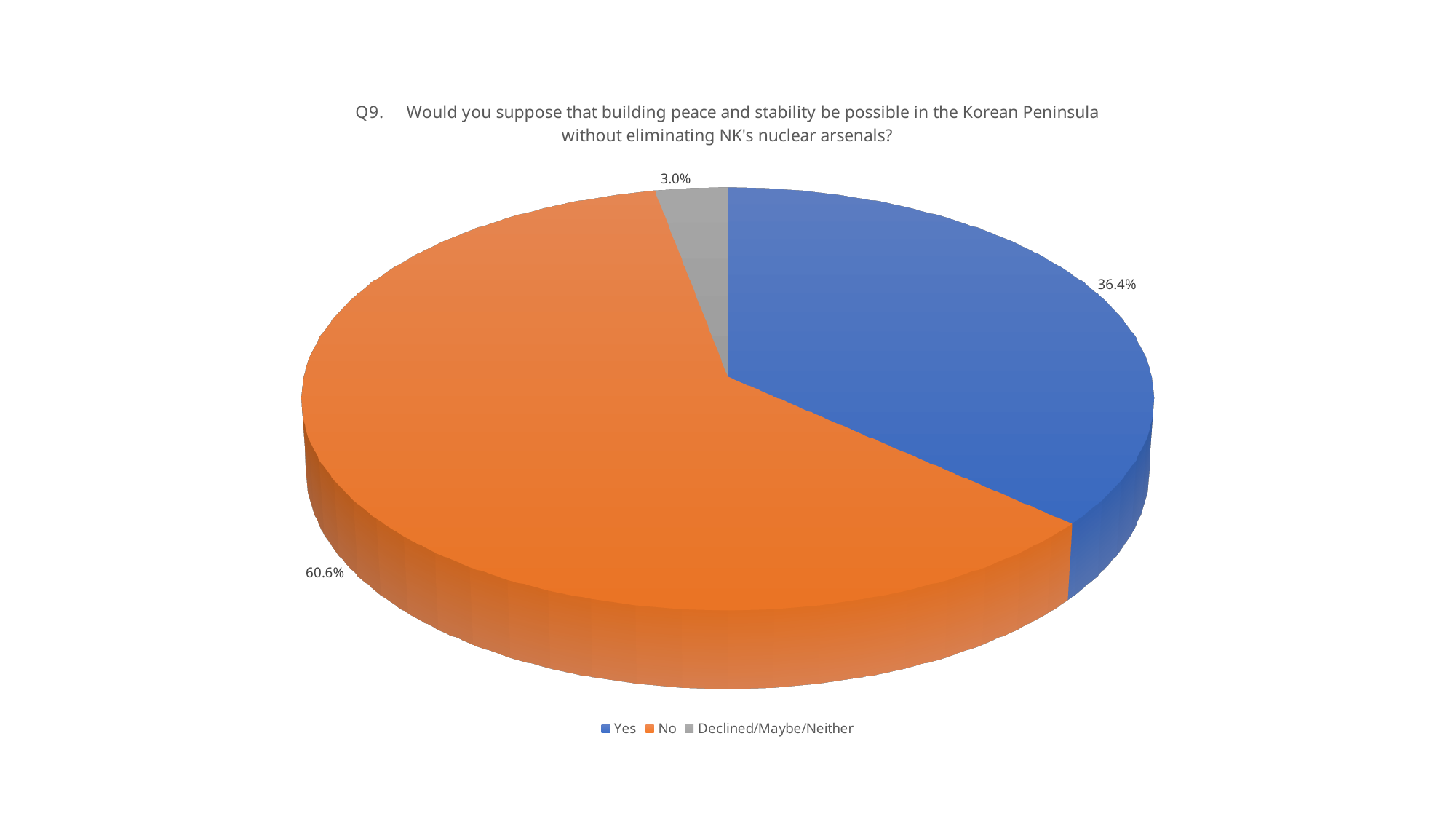
What percentage of respondents answered "Yes"? 36.4% What is the difference in percentage points between the "No" and "Yes" slices? 24.2 What kind of chart is shown on the slide? Pie chart What is the question number shown in the chart title? Q9 How many entries does the legend list? 3 What percentage of respondents answered "No"? 60.6% What colour is the "Yes" slice? Blue What percentage of respondents are in the "Declined/Maybe/Neither" category? 3.0% Which is larger, the "Yes" slice or the "No" slice? No Which response category has the largest share of the pie? No How many categories does the pie chart show? 3 Which response category has the smallest share of the pie? Declined/Maybe/Neither